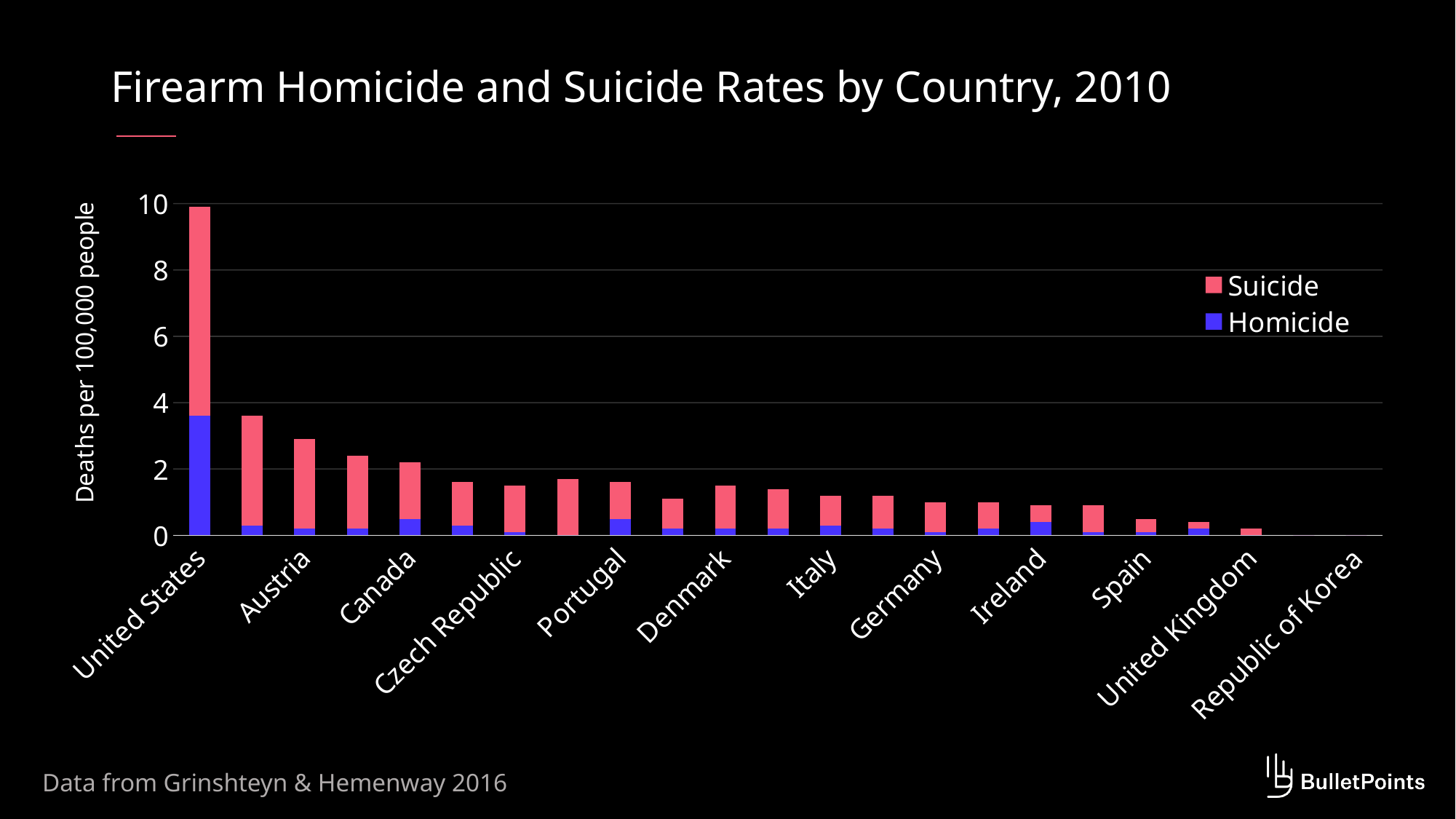
How many series does the legend list? 2 Is the total value for Spain greater or less than 1? less What kind of chart is shown on the slide? Stacked bar chart Which has a larger total value, the United States or Austria? United States Which country has the highest total firearm death rate? United States Is the total value for Italy greater or less than 2? less Is the total value for Austria greater or less than 4? less What is the label on the vertical axis? Deaths per 100,000 people What is the title of the chart? Firearm Homicide and Suicide Rates by Country, 2010 Do the total values generally rise or fall from left to right along the x axis? fall